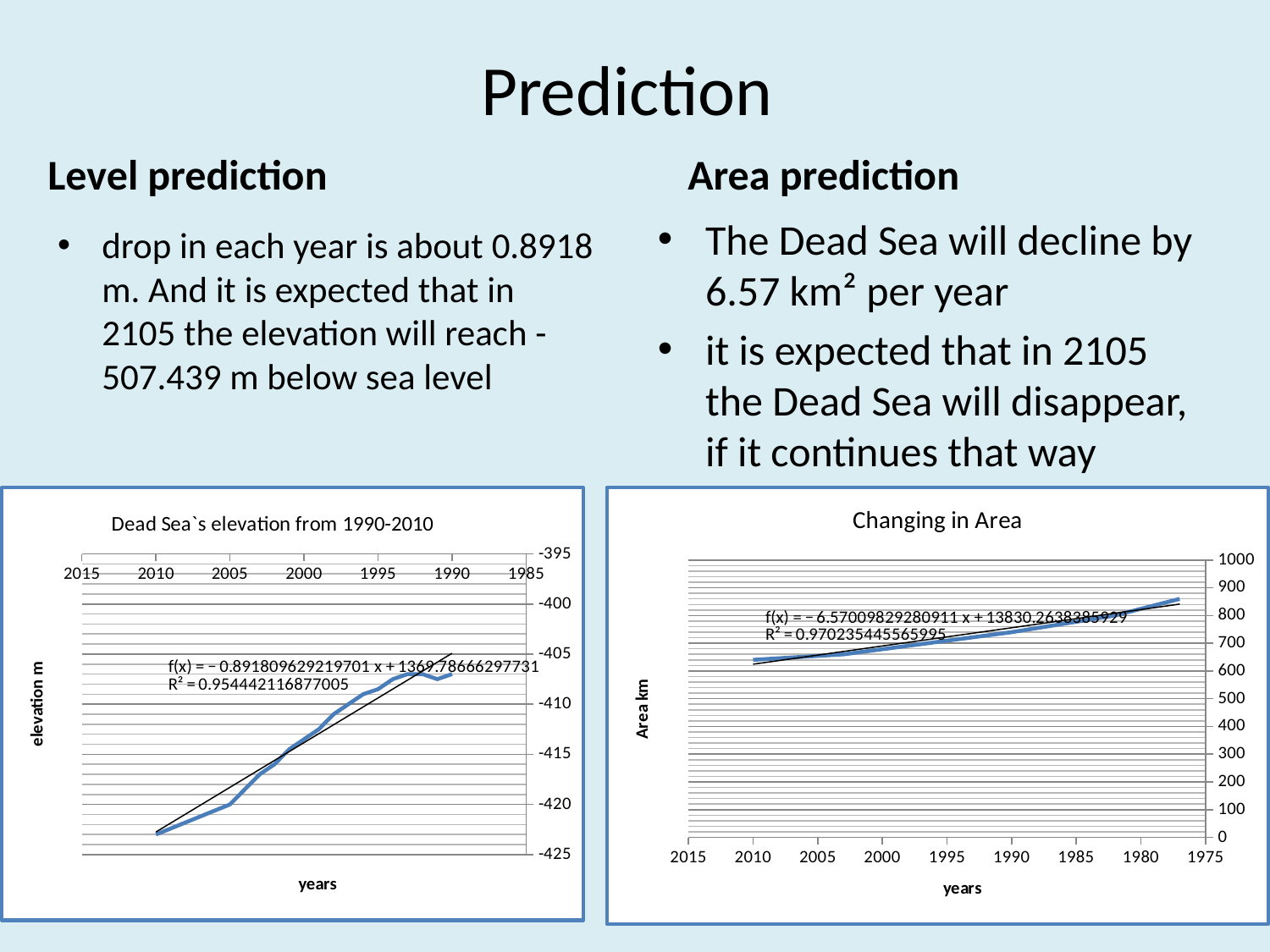
What kind of chart is the 'Dead Sea`s elevation from 1990-2010' chart? line chart In the 'Dead Sea`s elevation from 1990-2010' chart, does the elevation rise or fall as the years go from 1990 to 2010? fall What is the y-axis title of the 'Changing in Area' chart? Area km In the 'Changing in Area' chart, is the area value for 2010 greater or less than 700? less What R² value is printed on the 'Dead Sea`s elevation from 1990-2010' chart? 0.954442116877005 In the 'Changing in Area' chart, is the area value for 2010 greater or less than 600? greater What kind of chart is the 'Changing in Area' chart? line chart In the 'Changing in Area' chart, does the area rise or fall as the years go from 1980 to 2010? fall What is the title of the chart on the left of the slide? Dead Sea`s elevation from 1990-2010 In the 'Dead Sea`s elevation from 1990-2010' chart, is the elevation value for 2010 greater or less than -420? less